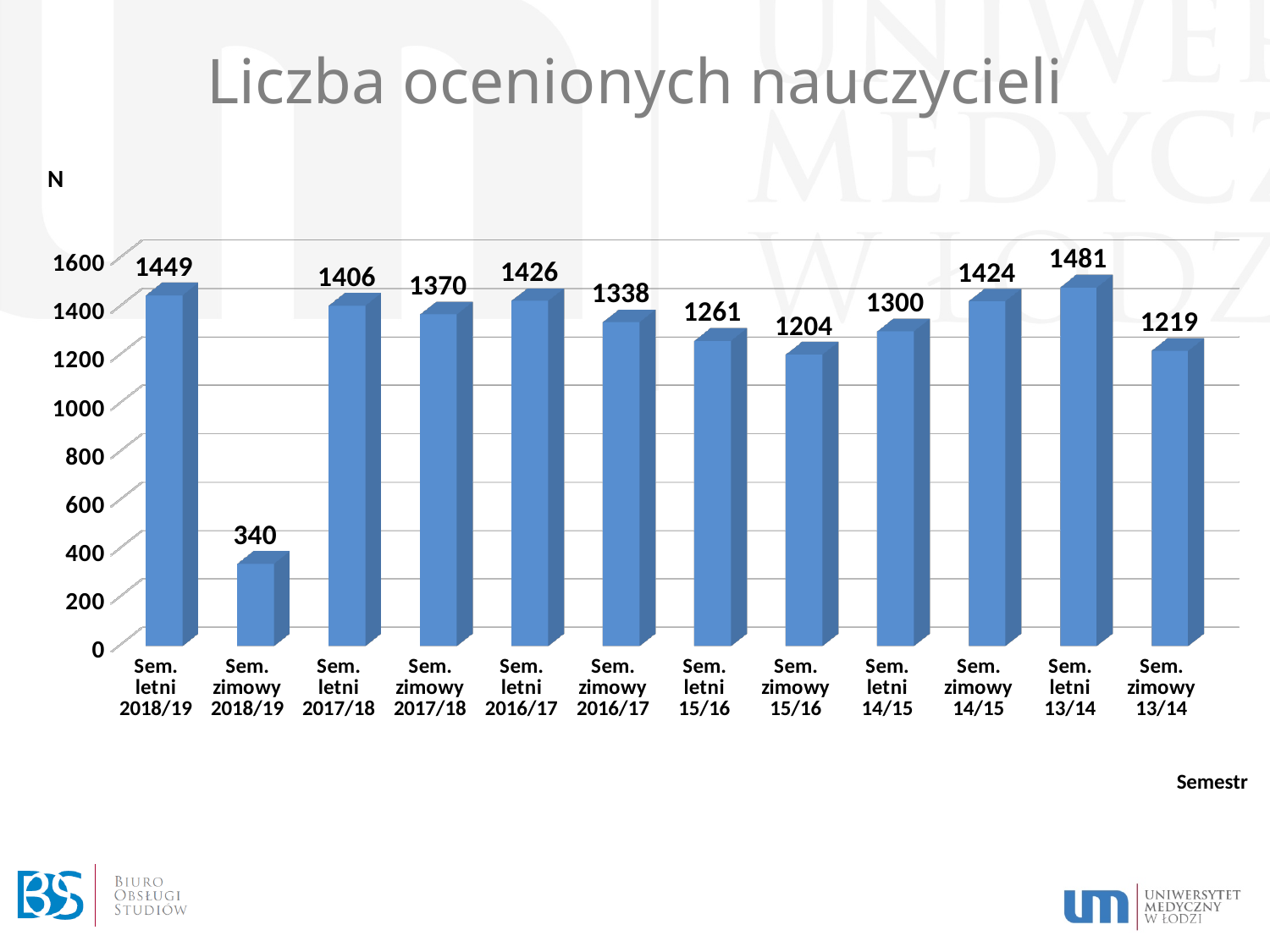
What kind of chart is shown on the slide? bar chart Is the value for Sem. zimowy 13/14 greater or less than 1200? greater Which semester has the highest number of evaluated teachers? Sem. letni 13/14 What is the label of the horizontal axis? Semestr What is the title of the chart? Liczba ocenionych nauczycieli What is the difference between Sem. letni 2018/19 and Sem. zimowy 2018/19? 1109 How many semesters are shown on the chart? 12 Which is larger, the value for Sem. letni 2017/18 or Sem. zimowy 2017/18? Sem. letni 2017/18 What is the value for Sem. zimowy 15/16? 1204 Which semester has the lowest number of evaluated teachers? Sem. zimowy 2018/19 What is the value for Sem. zimowy 2018/19? 340 What is the value for Sem. letni 2018/19? 1449